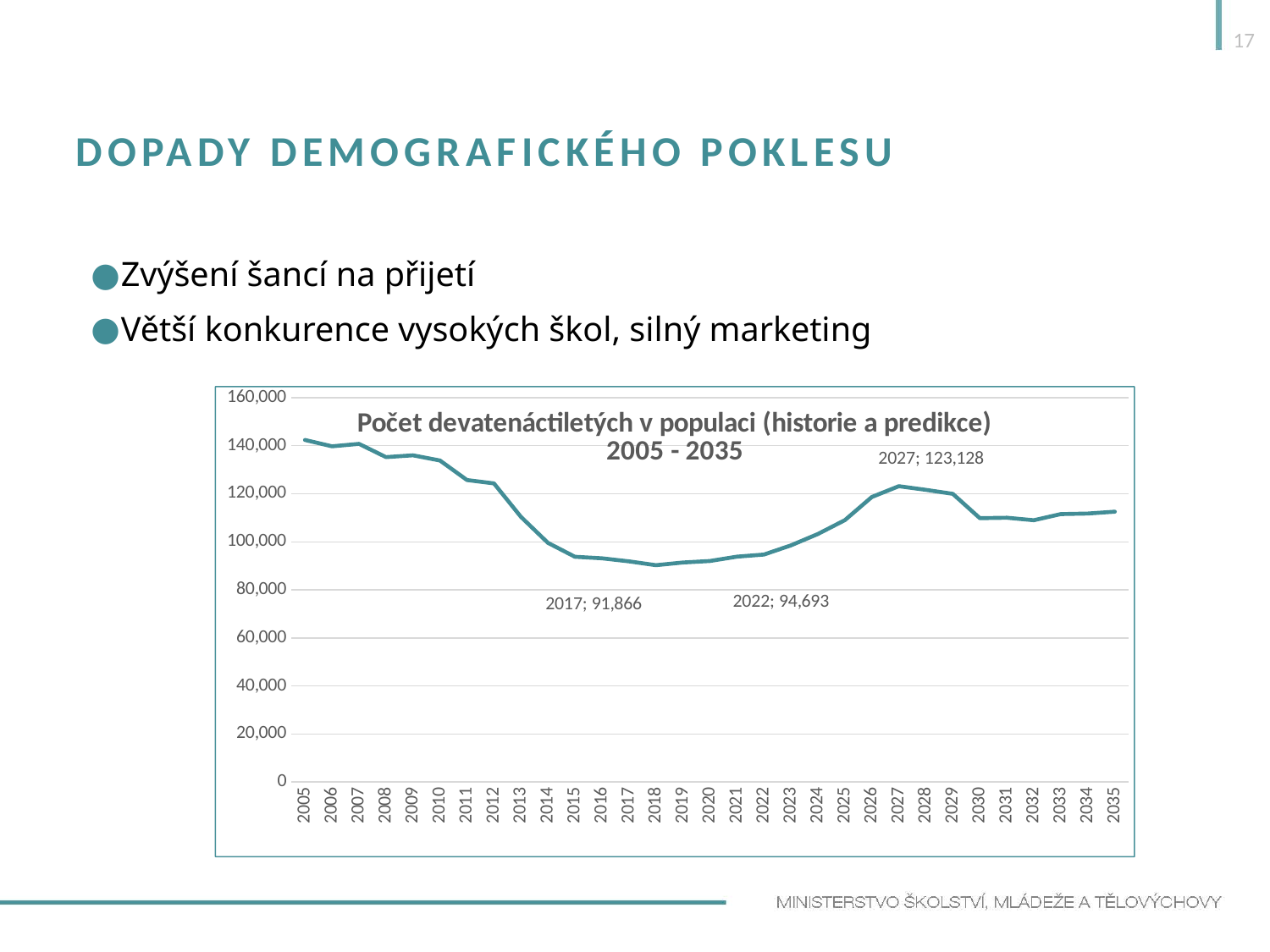
Does the line rise or fall between 2005 and 2018? fall What value is labelled for 2017? 91,866 Which year has the larger labelled value, 2017 or 2027? 2027 What is the difference between the labelled values for 2022 and 2017? 2,827 What value is labelled for 2022? 94,693 What value is labelled for 2027? 123,128 Is the value for 2010 greater or less than 140,000? less What is the title of the chart? Počet devatenáctiletých v populaci (historie a predikce) 2005 - 2035 Which year has the highest value on the chart? 2005 How many years are plotted along the x axis of the chart? 31 What kind of chart is shown on the slide? line chart What is the difference between the labelled values for 2027 and 2022? 28,435